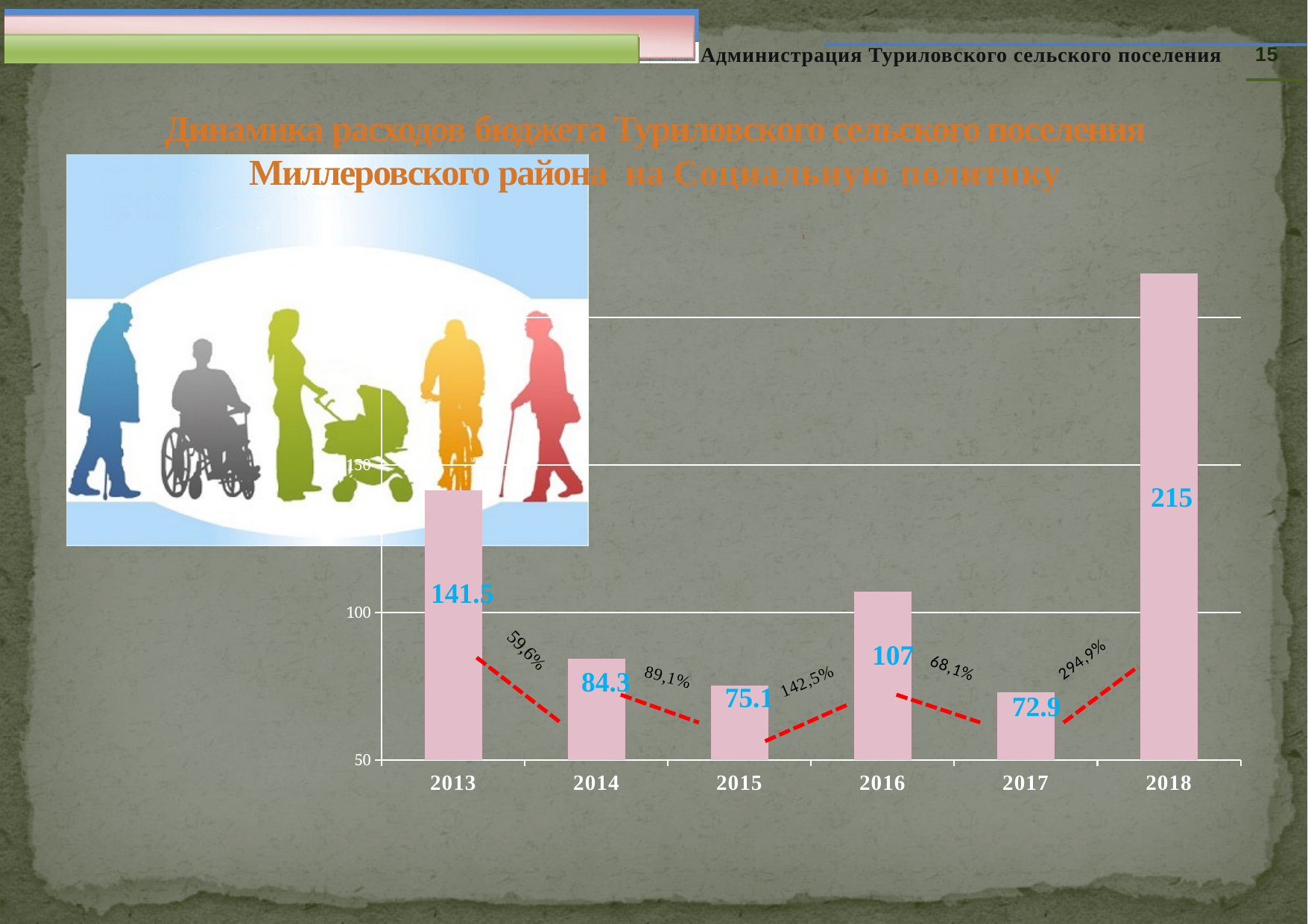
How many years are shown on the x axis? 6 What is the value for 2018? 215 What kind of chart is shown on the slide? bar chart What percentage label is shown between the 2017 and 2018 bars? 294,9% What is the difference between the values for 2018 and 2013? 73.5 What is the value for 2013? 141.5 What is the value for 2017? 72.9 Do the values rise or fall from 2013 to 2015? fall Which year has the lowest value? 2017 Is the value for 2016 greater or less than 100? greater Which year has the highest value? 2018 Which is larger, the value for 2016 or the value for 2014? 2016